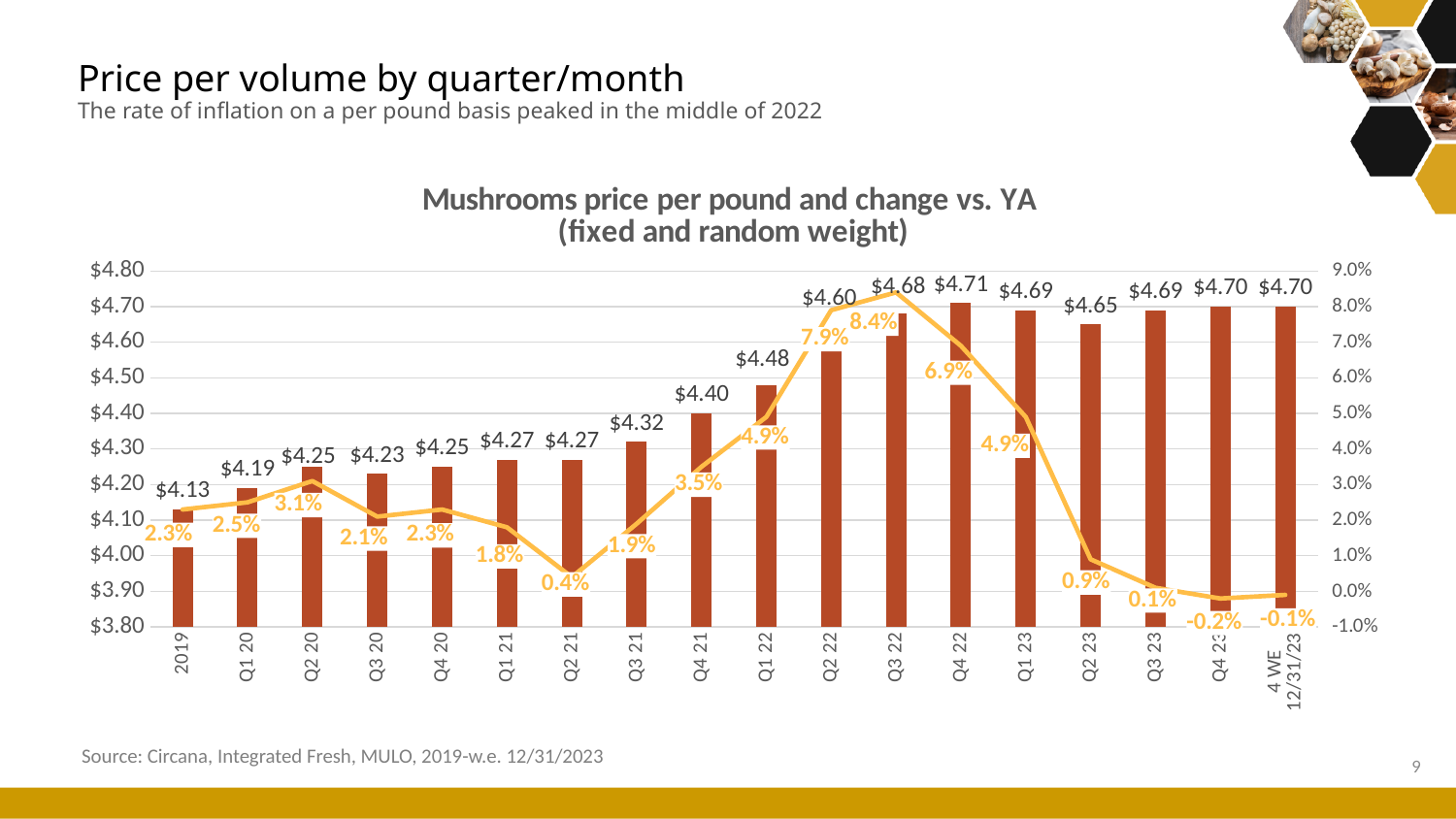
Does the price per pound rise or fall from 2019 to Q4 22? Rise Which has the higher price per pound, Q2 20 or Q3 20? Q2 20 Which period has the highest price per pound? Q4 22 Which period has the lowest change vs. YA? Q4 23 What is the difference in price per pound between Q4 22 and 2019? $0.58 What is the change vs. YA shown for Q3 22? 8.4% How many periods are shown on the x axis? 18 What is the mushrooms price per pound for Q4 21? $4.40 Which period has the lowest price per pound? 2019 What kind of chart is this? Bar and line chart What is the title of the chart? Mushrooms price per pound and change vs. YA (fixed and random weight) What is the change vs. YA shown for Q2 21? 0.4%